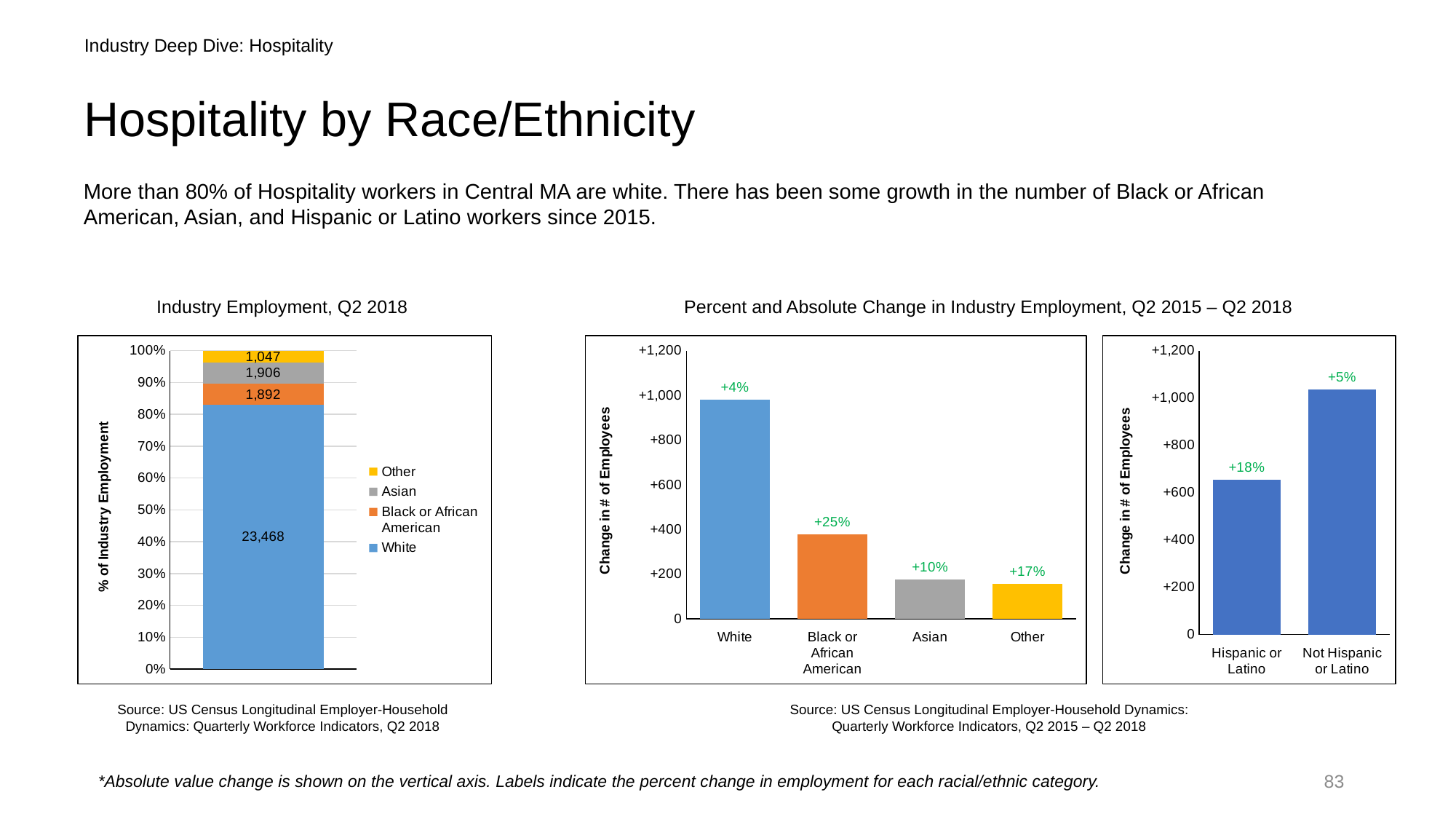
In the Industry Employment, Q2 2018 chart, what is the difference between the Asian and Black or African American values? 14 In the Industry Employment, Q2 2018 chart, what is the total of the stacked bar? 28,313 In the middle chart (change in employment by race), which category has the highest absolute change in number of employees? White In the middle chart (change in employment by race), how many categories are shown on the x axis? 4 In the Industry Employment, Q2 2018 chart, what is the value shown for Asian? 1,906 In the right-hand chart (Hispanic or Latino vs Not Hispanic or Latino), what percent change label is shown for Hispanic or Latino? +18% In the middle chart (change in employment by race), is the value for White greater or less than +800? greater In the middle chart (change in employment by race), what percent change label is shown for Black or African American? +25% In the Industry Employment, Q2 2018 chart, what is the value shown for White? 23,468 In the right-hand chart (Hispanic or Latino vs Not Hispanic or Latino), is the value for Not Hispanic or Latino greater or less than +1,000? greater In the Industry Employment, Q2 2018 chart, what is the value shown for Other? 1,047 How many series does the legend of the Industry Employment, Q2 2018 chart list? 4